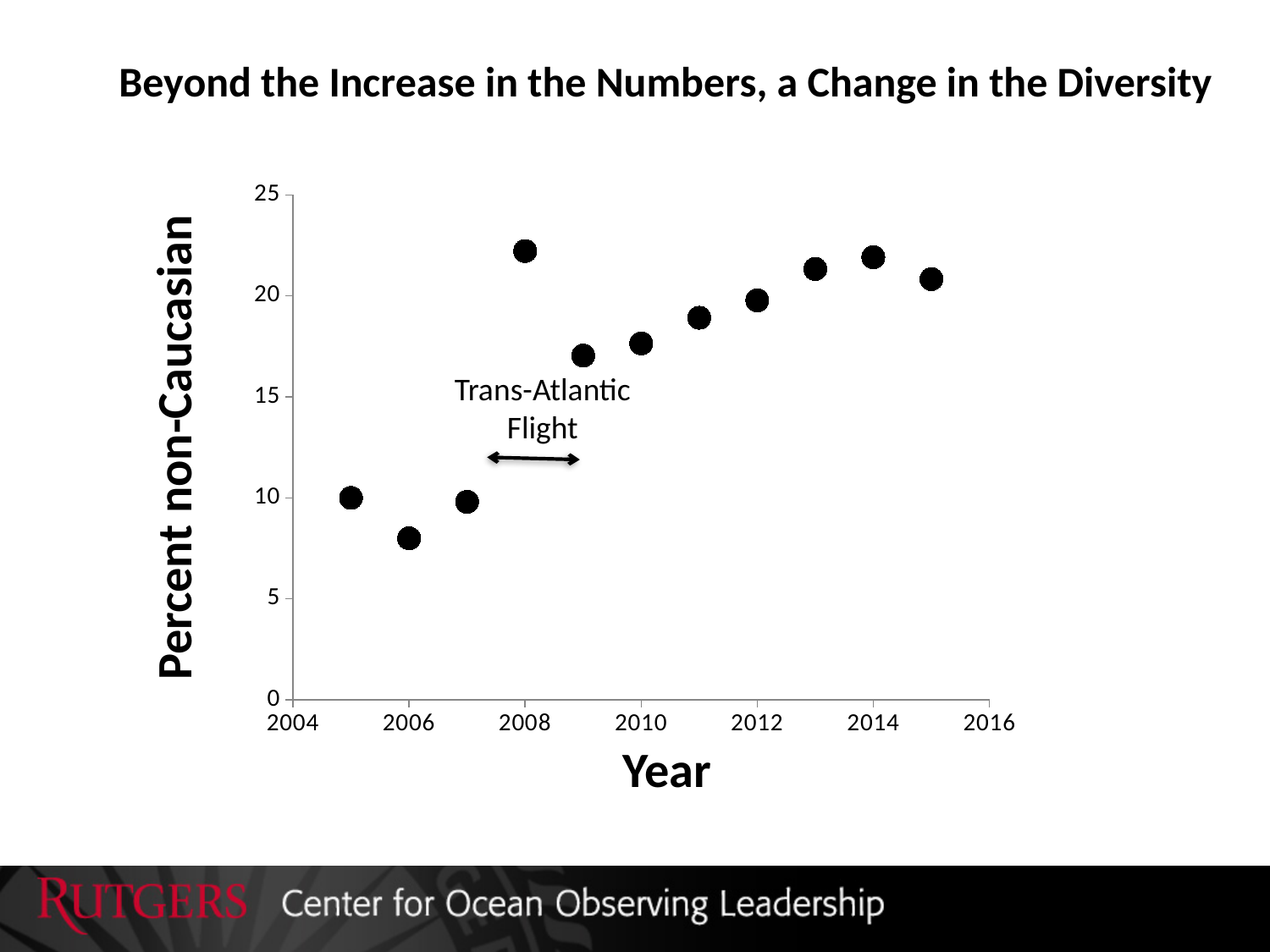
Which year has the lowest percent non-Caucasian? 2006 How many data points are plotted on the chart? 11 Is the value for 2011 greater or less than 20? less Which year has the larger percent non-Caucasian, 2006 or 2009? 2009 Is the value for 2009 greater or less than 15? greater What event is annotated on the chart between 2007 and 2009? Trans-Atlantic Flight What is the label on the y axis of the chart? Percent non-Caucasian What kind of chart is shown on the slide? scatter plot Overall, do the values rise or fall from 2005 to 2015? rise Is the value for 2013 greater or less than 20? greater